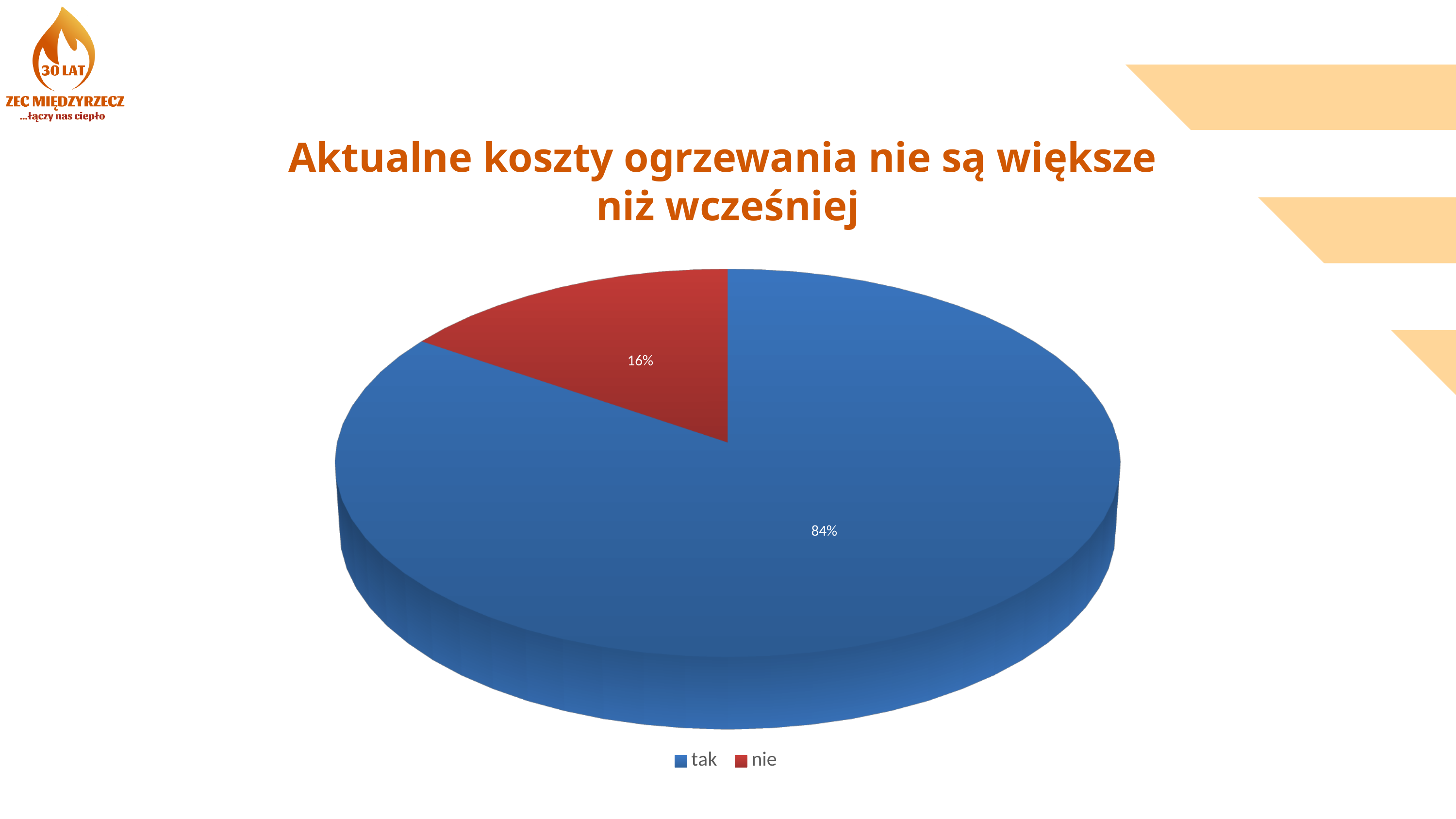
What is the difference in percentage points between the "tak" and "nie" slices? 68 What is the title of the chart? Aktualne koszty ogrzewania nie są większe niż wcześniej How many entries does the legend list? 2 Which category has the smallest slice of the pie? nie Which slice is larger, "tak" or "nie"? tak What kind of chart is shown on the slide? pie chart What share of the pie does "tak" represent? 84% What colour is the "nie" slice? red What share of the pie does "nie" represent? 16% How many slices does the pie chart have? 2 Which category has the largest slice of the pie? tak